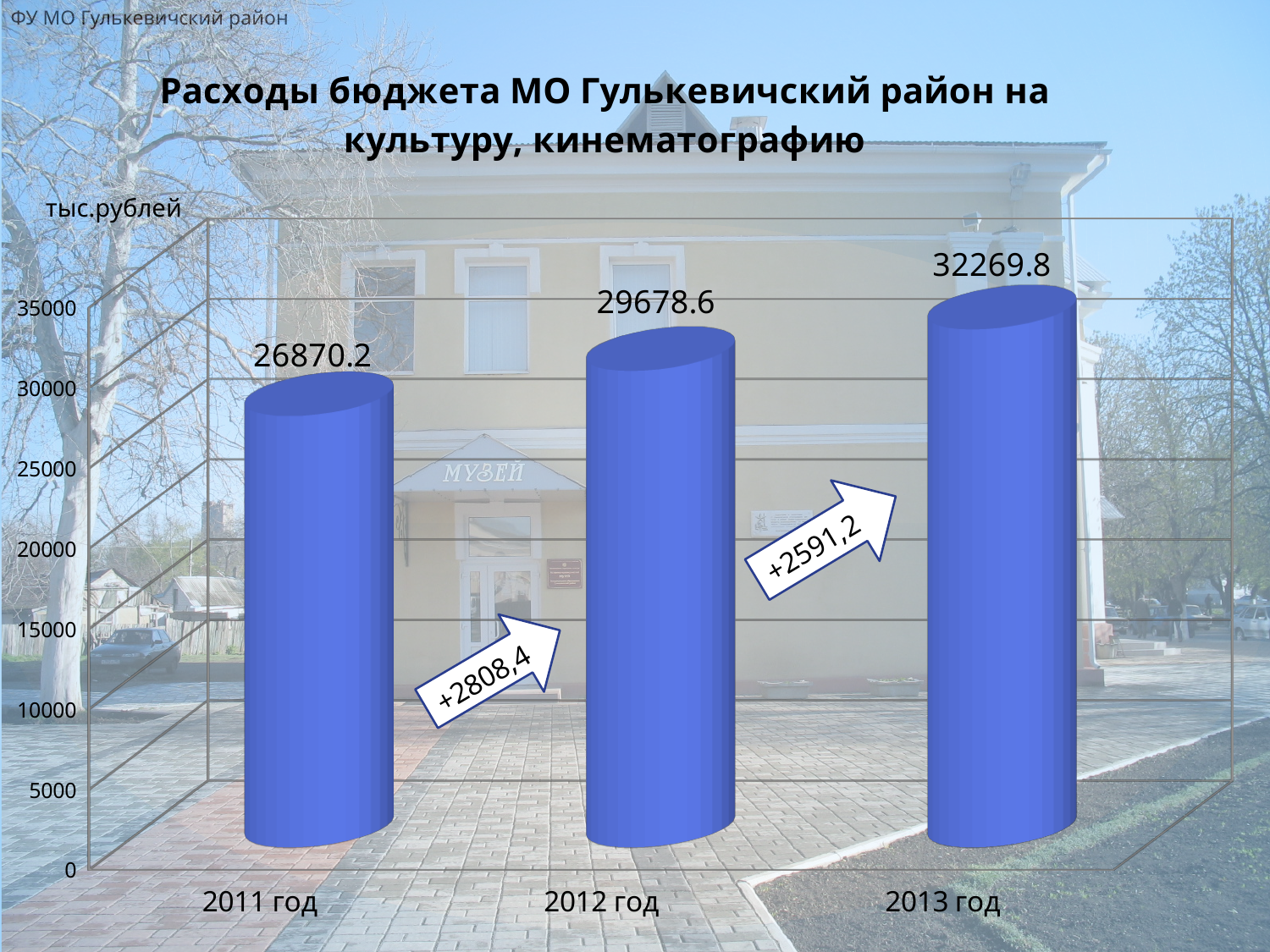
What is the difference between the values for 2013 год and 2012 год? 2591.2 What is the value for 2013 год? 32269.8 What is the difference between the values for 2013 год and 2011 год? 5399.6 Which is larger, the value for 2012 год or the value for 2013 год? 2013 год What is the value for 2011 год? 26870.2 Do the values rise or fall from 2011 год to 2013 год? rise What is the value for 2012 год? 29678.6 Is the value for 2011 год greater or less than 25000? greater How many years are shown on the chart? 3 Which year has the lowest value? 2011 год Which year has the highest value? 2013 год What is the difference between the values for 2012 год and 2011 год? 2808.4